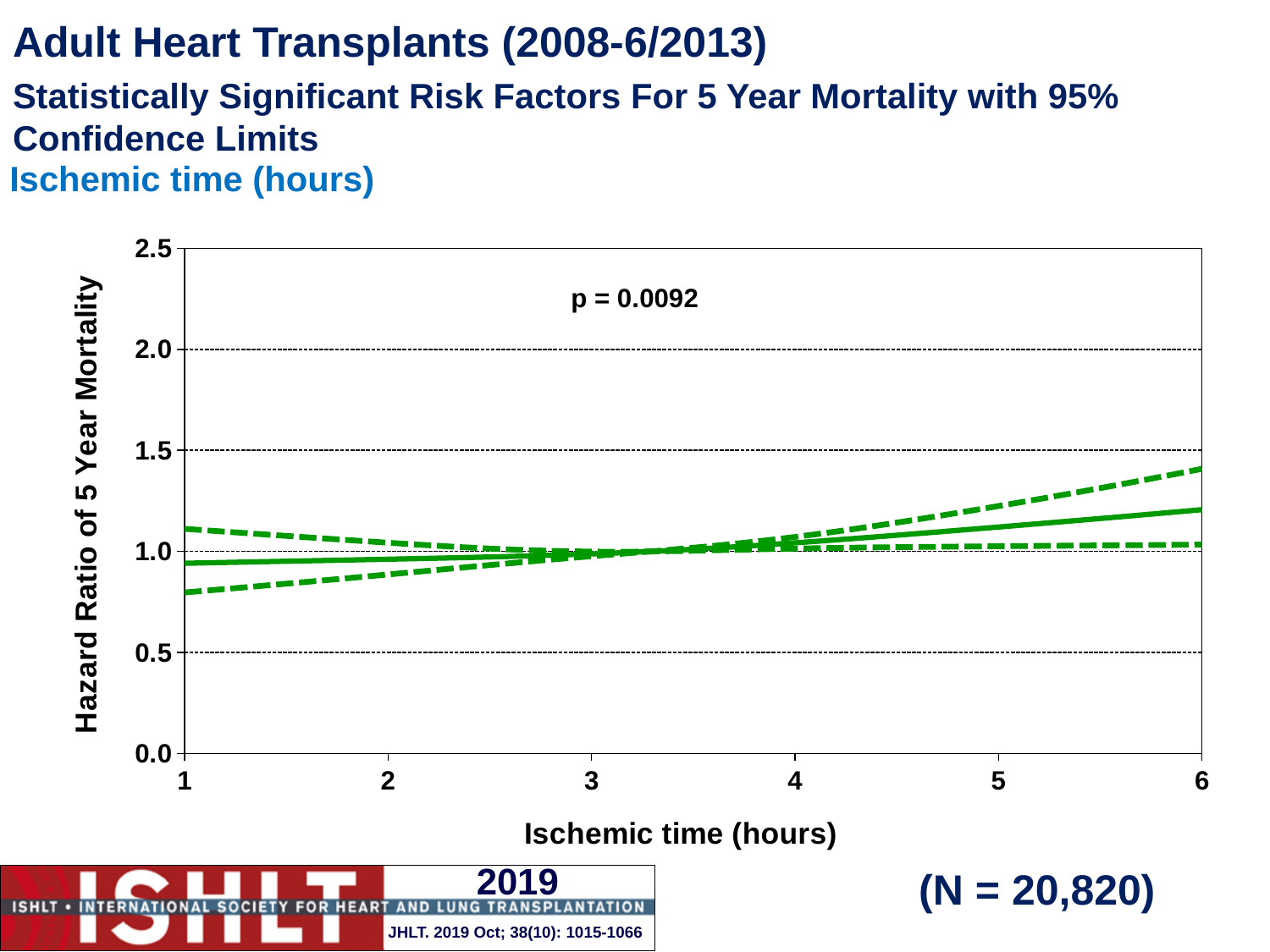
Is the lower 95% confidence limit (lower dashed line) at an ischemic time of 1 hour greater or less than 1.0? less Is the upper 95% confidence limit (upper dashed line) at an ischemic time of 6 hours greater or less than 1.5? less What kind of chart is shown on the slide? Line chart What is the label of the y axis? Hazard Ratio of 5 Year Mortality Is the hazard ratio (solid line) at an ischemic time of 6 hours greater or less than 1.5? less How many lines are plotted on the chart? 3 What p-value is printed on the chart? p = 0.0092 Does the solid hazard ratio line rise or fall as ischemic time increases from 1 to 6 hours? Rises